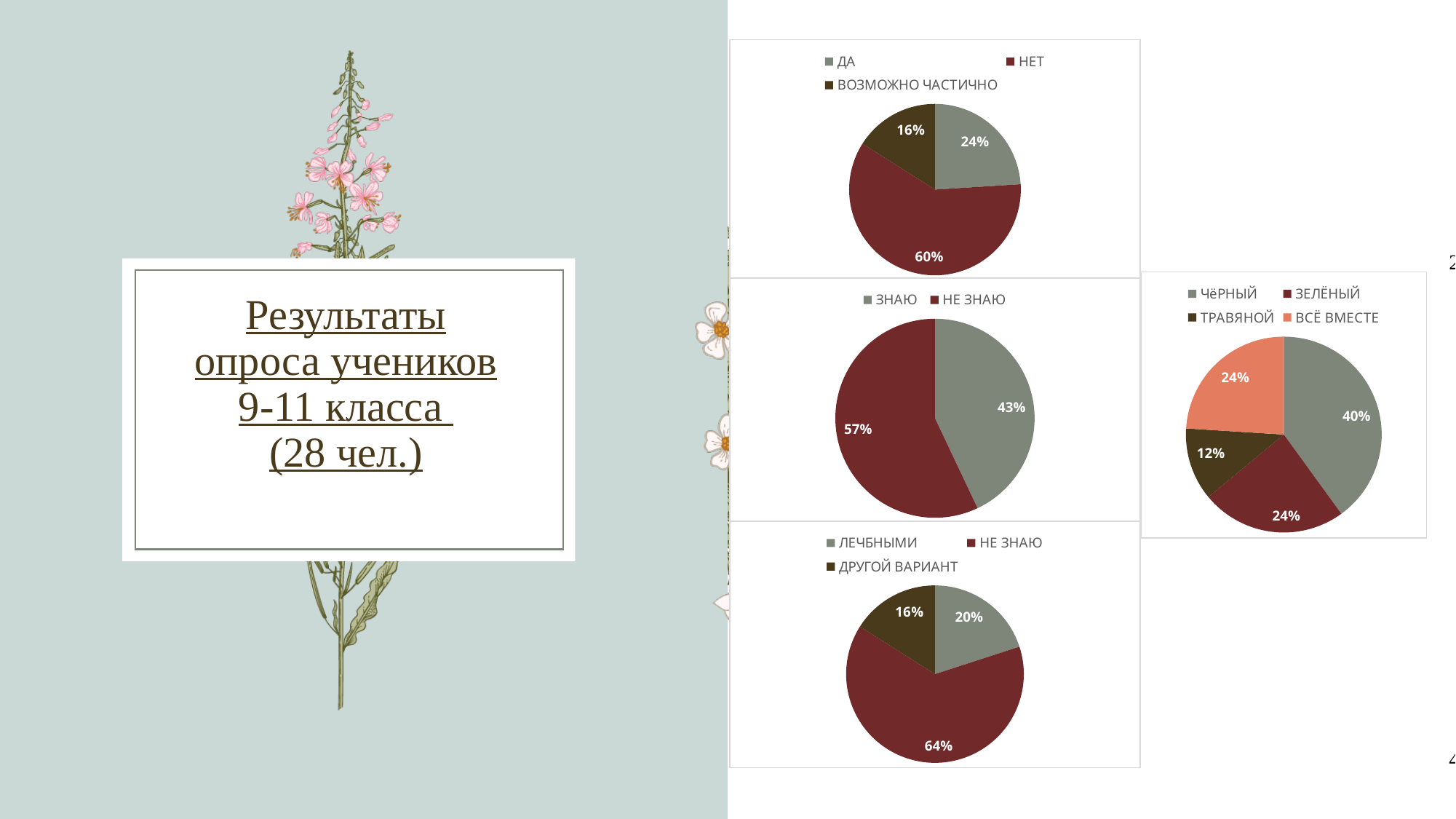
In the middle pie chart in the left column (legend ЗНАЮ / НЕ ЗНАЮ), what is the difference between the НЕ ЗНАЮ and ЗНАЮ shares? 14% In the bottom pie chart in the left column (legend ЛЕЧБНЫМИ / НЕ ЗНАЮ / ДРУГОЙ ВАРИАНТ), which is larger, ЛЕЧБНЫМИ or ДРУГОЙ ВАРИАНТ? ЛЕЧБНЫМИ In the middle pie chart in the left column (legend ЗНАЮ / НЕ ЗНАЮ), what share does НЕ ЗНАЮ have? 57% What type of chart is the chart on the right of the slide (legend ЧёРНЫЙ / ЗЕЛЁНЫЙ / ТРАВЯНОЙ / ВСЁ ВМЕСТЕ)? Pie chart In the bottom pie chart in the left column (legend ЛЕЧБНЫМИ / НЕ ЗНАЮ / ДРУГОЙ ВАРИАНТ), what share does НЕ ЗНАЮ have? 64% In the pie chart on the right (legend ЧёРНЫЙ / ЗЕЛЁНЫЙ / ТРАВЯНОЙ / ВСЁ ВМЕСТЕ), which category has the largest share? ЧёРНЫЙ In the pie chart on the right (legend ЧёРНЫЙ / ЗЕЛЁНЫЙ / ТРАВЯНОЙ / ВСЁ ВМЕСТЕ), how many categories does the legend list? 4 In the top pie chart in the left column (legend ДА / НЕТ / ВОЗМОЖНО ЧАСТИЧНО), which category has the smallest share? ВОЗМОЖНО ЧАСТИЧНО In the top pie chart in the left column (legend ДА / НЕТ / ВОЗМОЖНО ЧАСТИЧНО), what share does НЕТ have? 60% In the middle pie chart in the left column (legend ЗНАЮ / НЕ ЗНАЮ), how many slices does the pie have? 2 In the top pie chart in the left column (legend ДА / НЕТ / ВОЗМОЖНО ЧАСТИЧНО), what share does ДА have? 24% In the pie chart on the right (legend ЧёРНЫЙ / ЗЕЛЁНЫЙ / ТРАВЯНОЙ / ВСЁ ВМЕСТЕ), what share does ТРАВЯНОЙ have? 12%